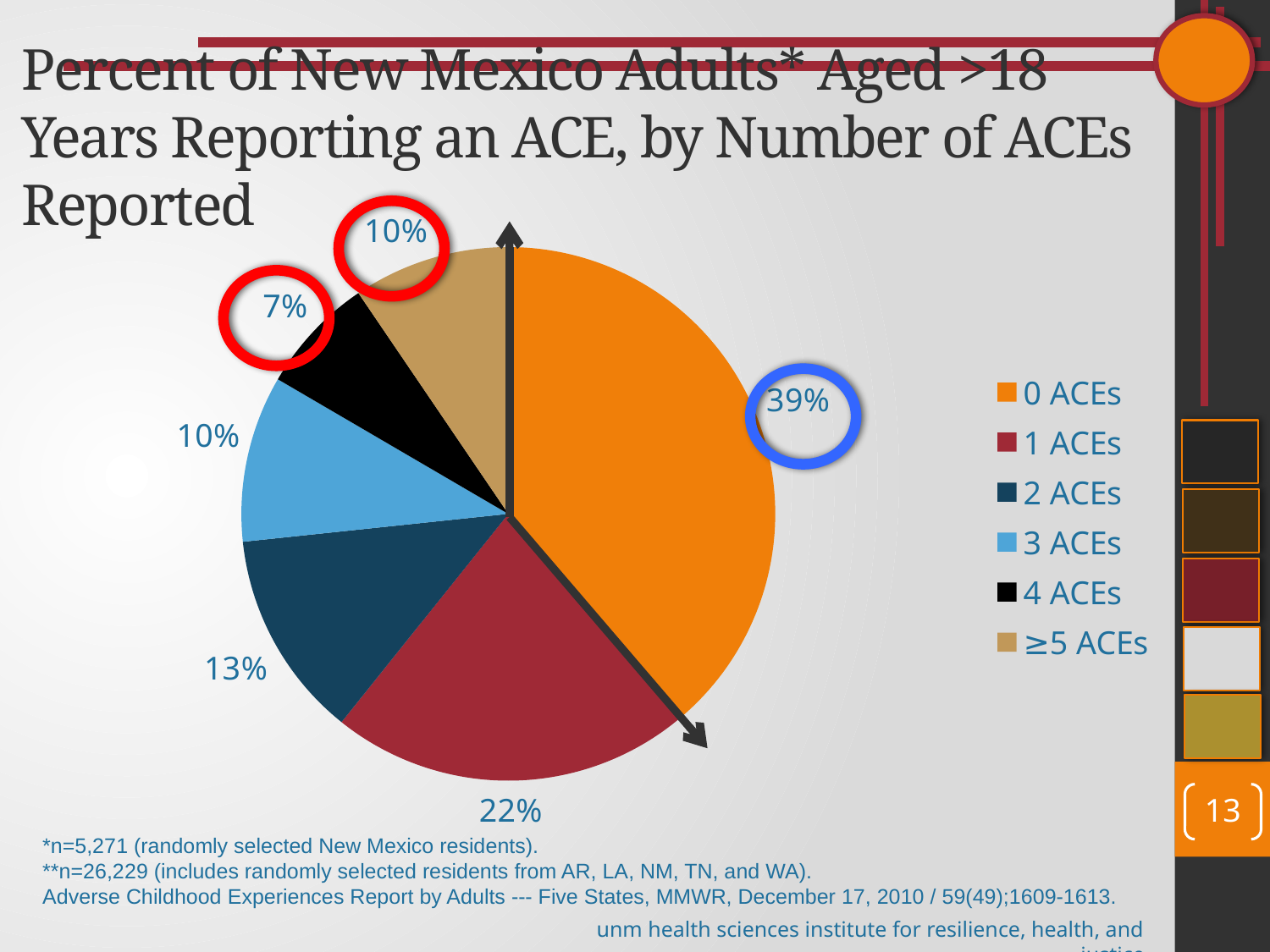
What is the difference in percentage points between the 0 ACEs slice and the 1 ACEs slice? 17 Which category has the largest share of the pie? 0 ACEs Which is larger, the share for 2 ACEs or the share for 3 ACEs? 2 ACEs What percentage of New Mexico adults reported 2 ACEs? 13% How many categories does the legend list? 6 Which category has the smallest share of the pie? 4 ACEs Which colour represents the 1 ACEs category in the legend? dark red What percentage of New Mexico adults reported 1 ACEs? 22% What percentage of New Mexico adults reported ≥5 ACEs? 10% What type of chart is shown on the slide? pie chart What percentage of New Mexico adults reported 4 ACEs? 7% What percentage of New Mexico adults reported 0 ACEs? 39%